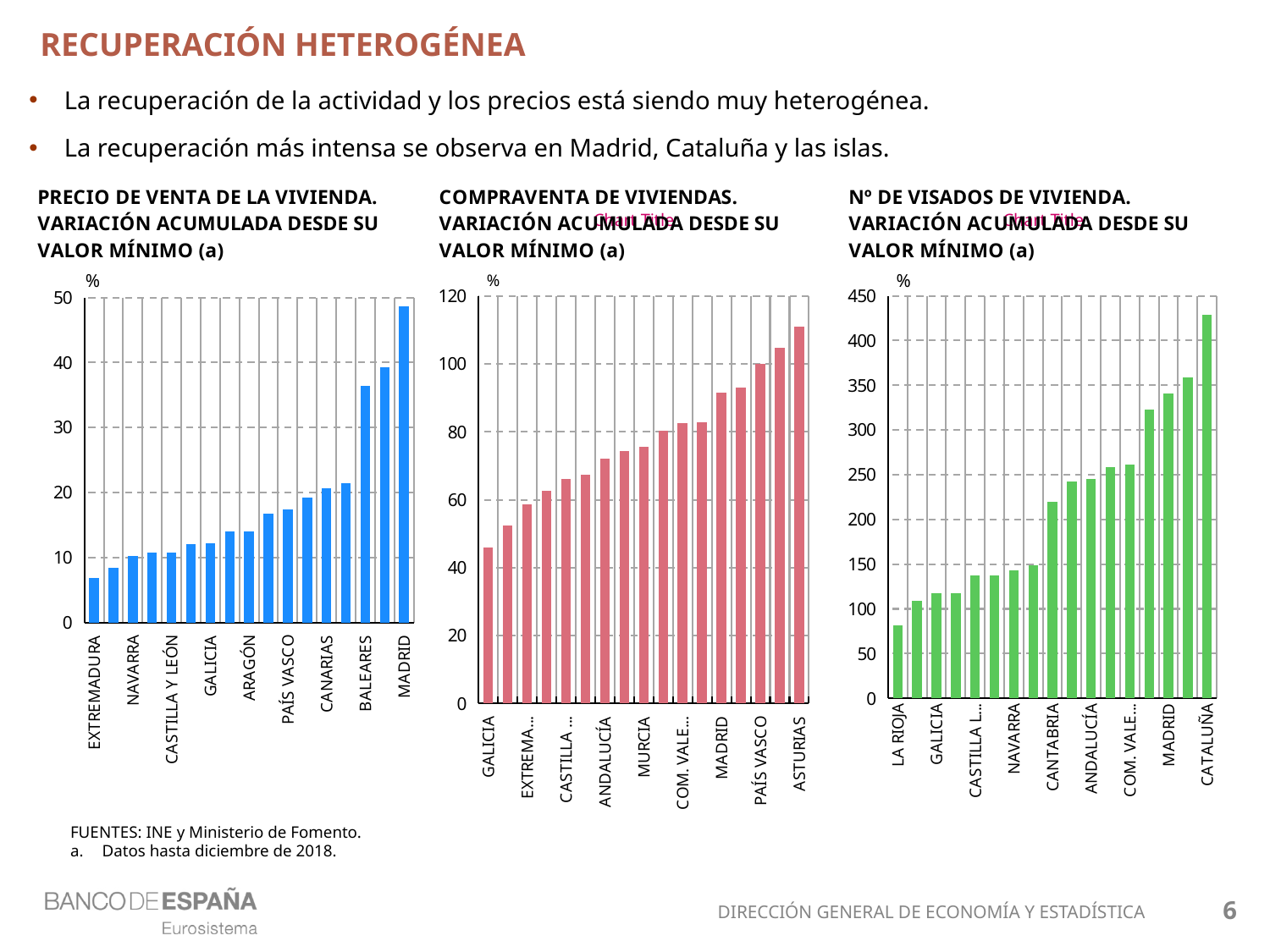
What type of chart is the chart titled 'Nº DE VISADOS DE VIVIENDA'? bar chart In the chart titled 'Nº DE VISADOS DE VIVIENDA', is the value for CATALUÑA greater or less than 400? greater In the chart titled 'COMPRAVENTA DE VIVIENDAS', is the value for GALICIA greater or less than 60? less In the chart titled 'COMPRAVENTA DE VIVIENDAS', which region has the lowest value? GALICIA In the chart titled 'Nº DE VISADOS DE VIVIENDA', which region has the highest value? CATALUÑA In the chart titled 'PRECIO DE VENTA DE LA VIVIENDA', is the value for BALEARES greater or less than 30? greater In the chart titled 'COMPRAVENTA DE VIVIENDAS', which region has the highest value? ASTURIAS In the chart titled 'COMPRAVENTA DE VIVIENDAS', which is larger, the value for MADRID or the value for MURCIA? MADRID In the chart titled 'PRECIO DE VENTA DE LA VIVIENDA', which region has the highest value? MADRID In the chart titled 'PRECIO DE VENTA DE LA VIVIENDA', which labelled region has the lowest value? EXTREMADURA